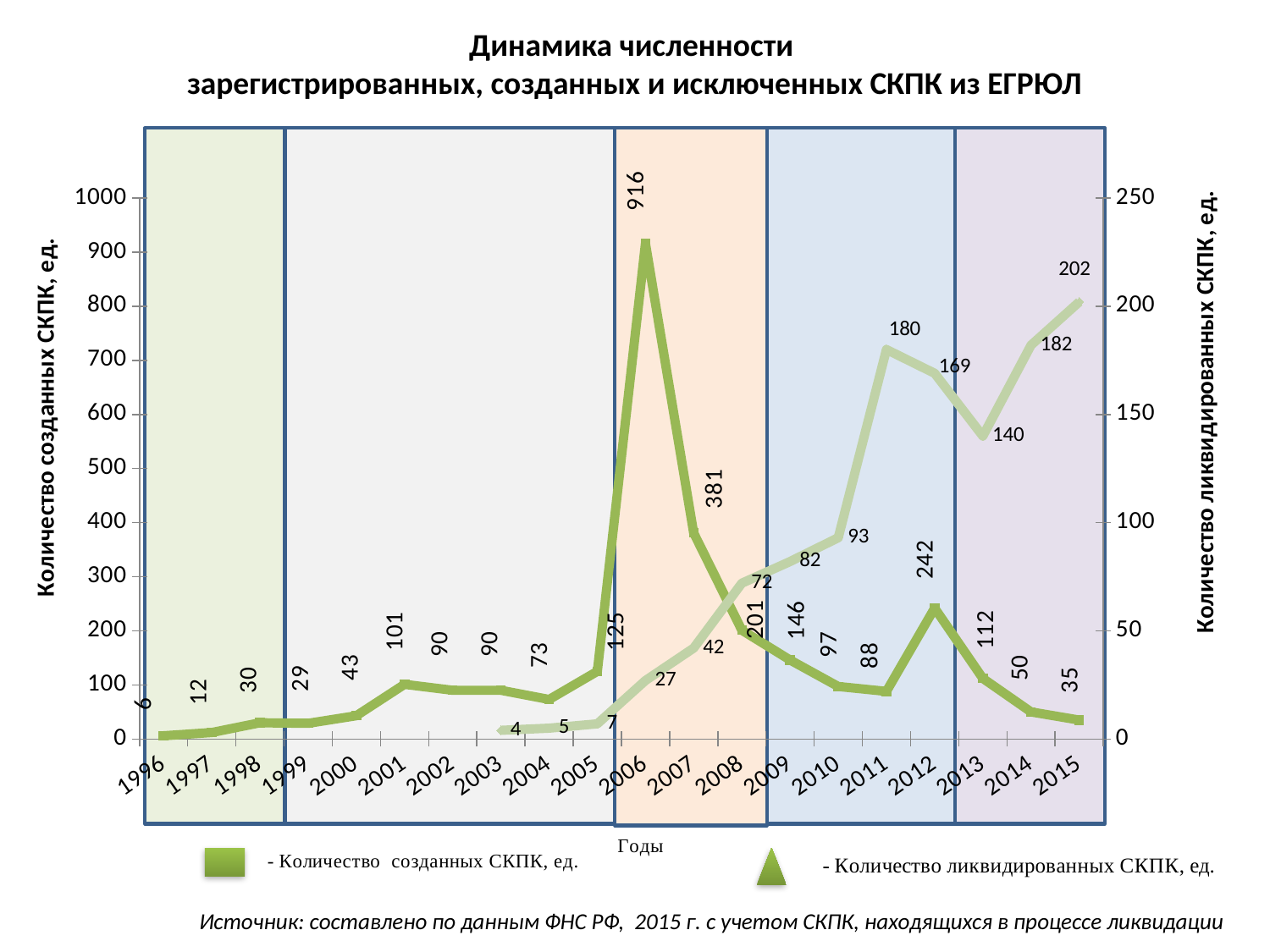
What is the number of created SKPK (Количество созданных СКПК) in 2006? 916 Does the number of liquidated SKPK rise or fall from 2003 to 2011? rise In which year is the number of created SKPK lowest? 1996 What type of chart is shown on the slide? line chart What is the number of liquidated SKPK (Количество ликвидированных СКПК) in 2015? 202 In which year is the number of liquidated SKPK highest? 2015 Which is larger: the number of liquidated SKPK in 2011 or in 2013? 2011 What is the difference between the number of created SKPK in 2006 and in 2007? 535 In which year is the number of created SKPK highest? 2006 How many series does the legend list? 2 How many years are shown on the x axis? 20 What is the number of created SKPK in 2012? 242